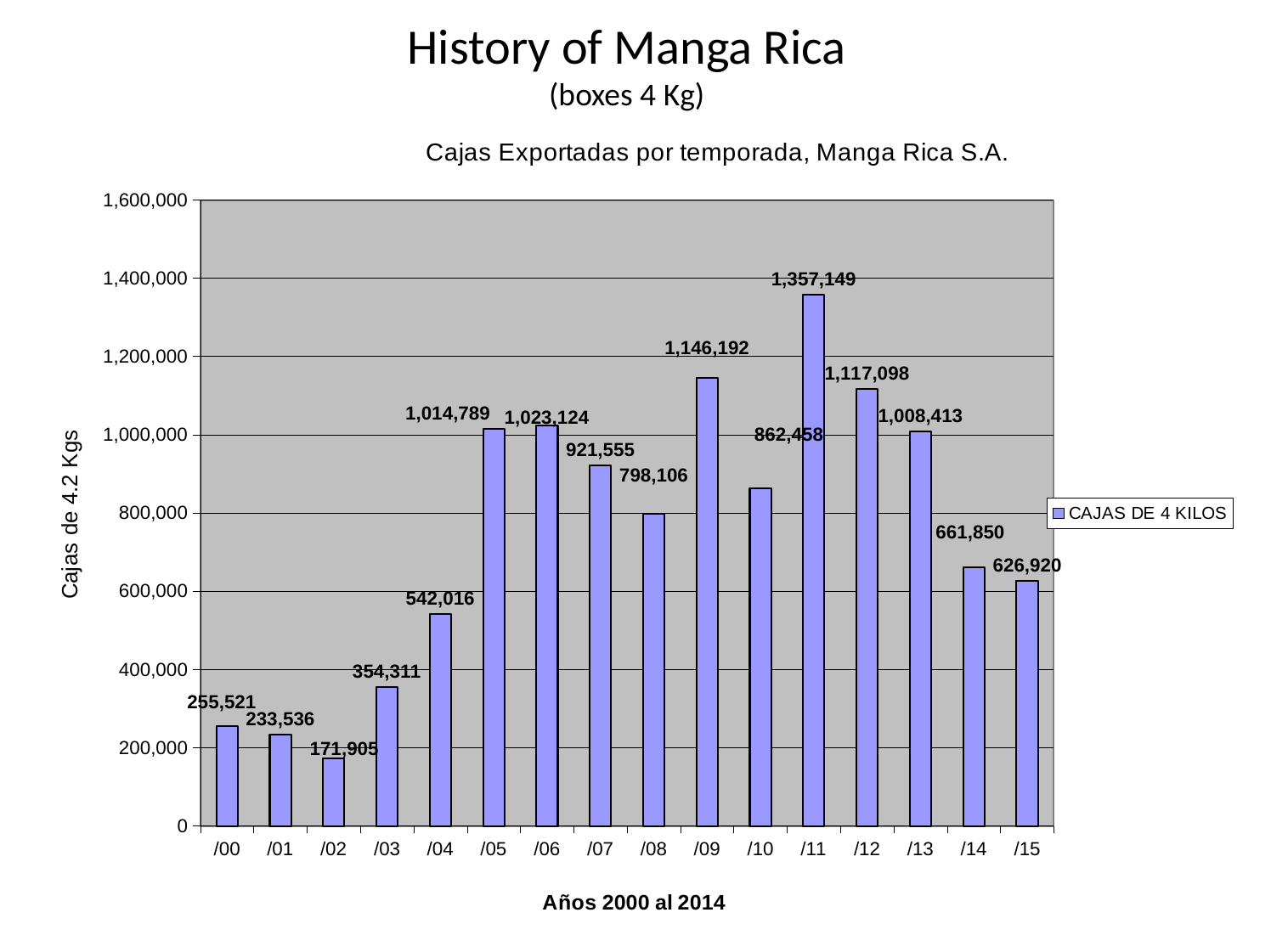
What is the value for /15? 626,920 What is the difference between the values for /11 and /10? 494,691 How many series does the legend list? 1 Which is larger, the value for /09 or the value for /12? /09 How many years are shown on the x axis? 16 What is the difference between the values for /14 and /15? 34,930 What is the value for /11? 1,357,149 Do the values rise or fall from /02 to /06? rise Which year has the highest value? /11 What is the value for /04? 542,016 Which year has the lowest value? /02 What kind of chart is this? bar chart